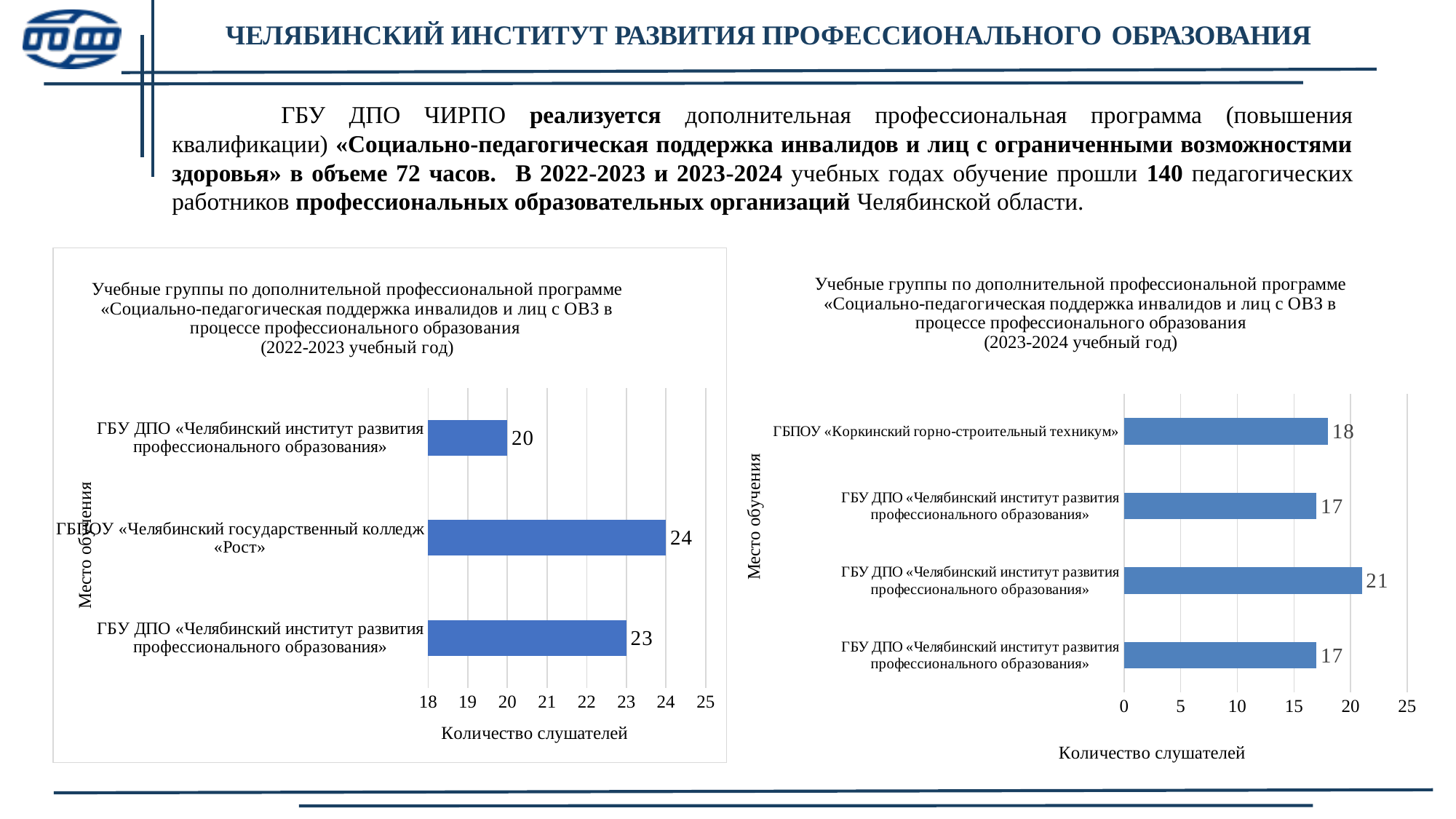
In the left chart (2022-2023 учебный год), what is the value of the topmost bar? 20 In the right chart (2023-2024 учебный год), how many слушателей are shown for ГБПОУ «Коркинский горно-строительный техникум»? 18 In the left chart (2022-2023 учебный год), which category has the highest number of слушателей? ГБПОУ «Челябинский государственный колледж «Рост» In the right chart (2023-2024 учебный год), what is the lowest value shown? 17 In the left chart (2022-2023 учебный год), what is the difference between the value for ГБПОУ «Челябинский государственный колледж «Рост» and the topmost bar? 4 In the right chart (2023-2024 учебный год), is the value for ГБПОУ «Коркинский горно-строительный техникум» greater or less than 20? less What is the x-axis title of the right chart (2023-2024 учебный год)? Количество слушателей In the right chart (2023-2024 учебный год), what is the highest value shown? 21 In the right chart (2023-2024 учебный год), how many bars are plotted? 4 In the left chart (2022-2023 учебный год), how many слушателей are shown for ГБПОУ «Челябинский государственный колледж «Рост»? 24 What type of chart is the left chart (2022-2023 учебный год)? bar chart In the left chart (2022-2023 учебный год), how many bars are plotted? 3